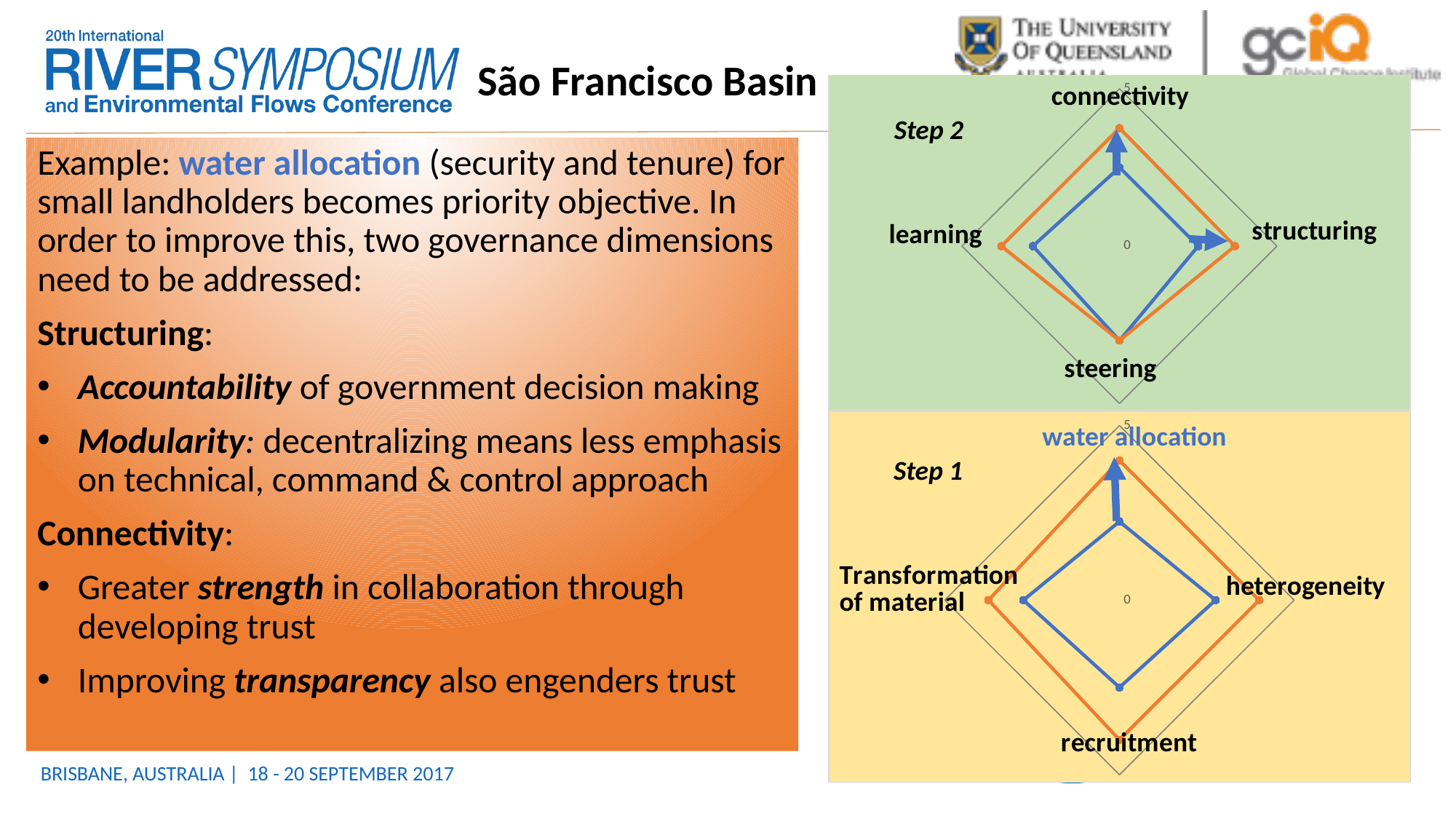
How many axes (categories) does the Step 2 radar chart have? 4 On the Step 1 radar chart, which series has the larger value for water allocation, the blue or the orange? orange How many data series are plotted on the Step 2 radar chart? 2 On the Step 2 radar chart, which series has the larger value for connectivity, the blue or the orange? orange How many axes (categories) does the Step 1 radar chart have? 4 How many data series are plotted on the Step 1 radar chart? 2 What kind of chart is the Step 1 chart at the bottom right of the slide? radar chart What is the maximum value shown on the axis scale of the Step 1 radar chart? 5 Which category on the Step 1 radar chart is highlighted in blue text? water allocation What kind of chart is the Step 2 chart at the top right of the slide? radar chart On the Step 2 radar chart, is the blue series value for steering greater or less than 5? less On the Step 1 radar chart, is the blue series value for heterogeneity greater or less than 5? less